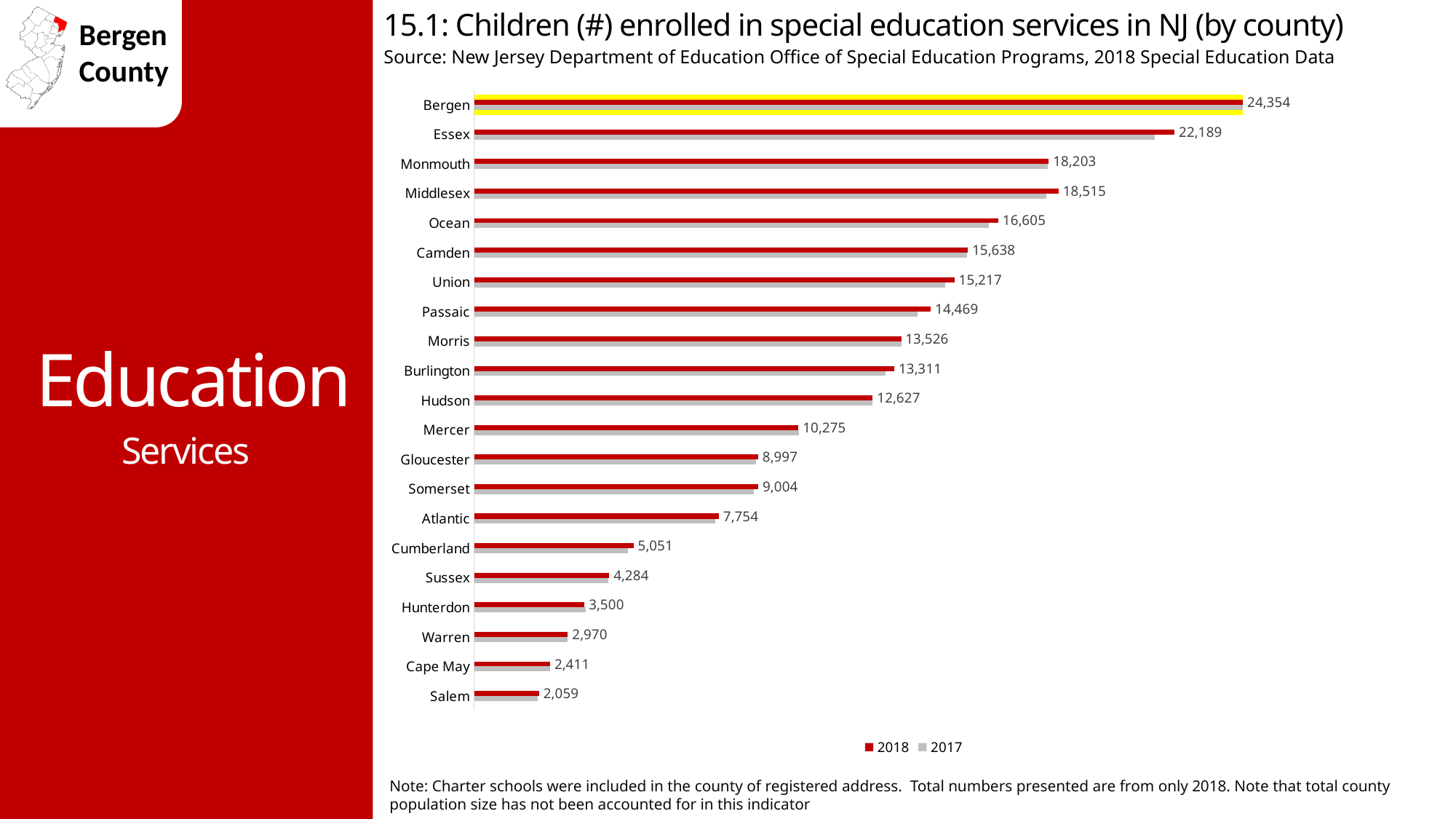
Which county's bars are highlighted in yellow? Bergen What is the 2018 value for Bergen? 24,354 What kind of chart is shown on the slide? bar chart What is the 2018 value for Mercer? 10,275 How many series does the legend list? 2 Which county has the highest 2018 value? Bergen Which has the larger 2018 value, Middlesex or Monmouth? Middlesex What is the 2018 value for Salem? 2,059 How many counties are shown in the chart? 21 Which county has the lowest 2018 value? Salem What is the difference between the 2018 values for Bergen and Essex? 2,165 What is the 2018 value for Essex? 22,189